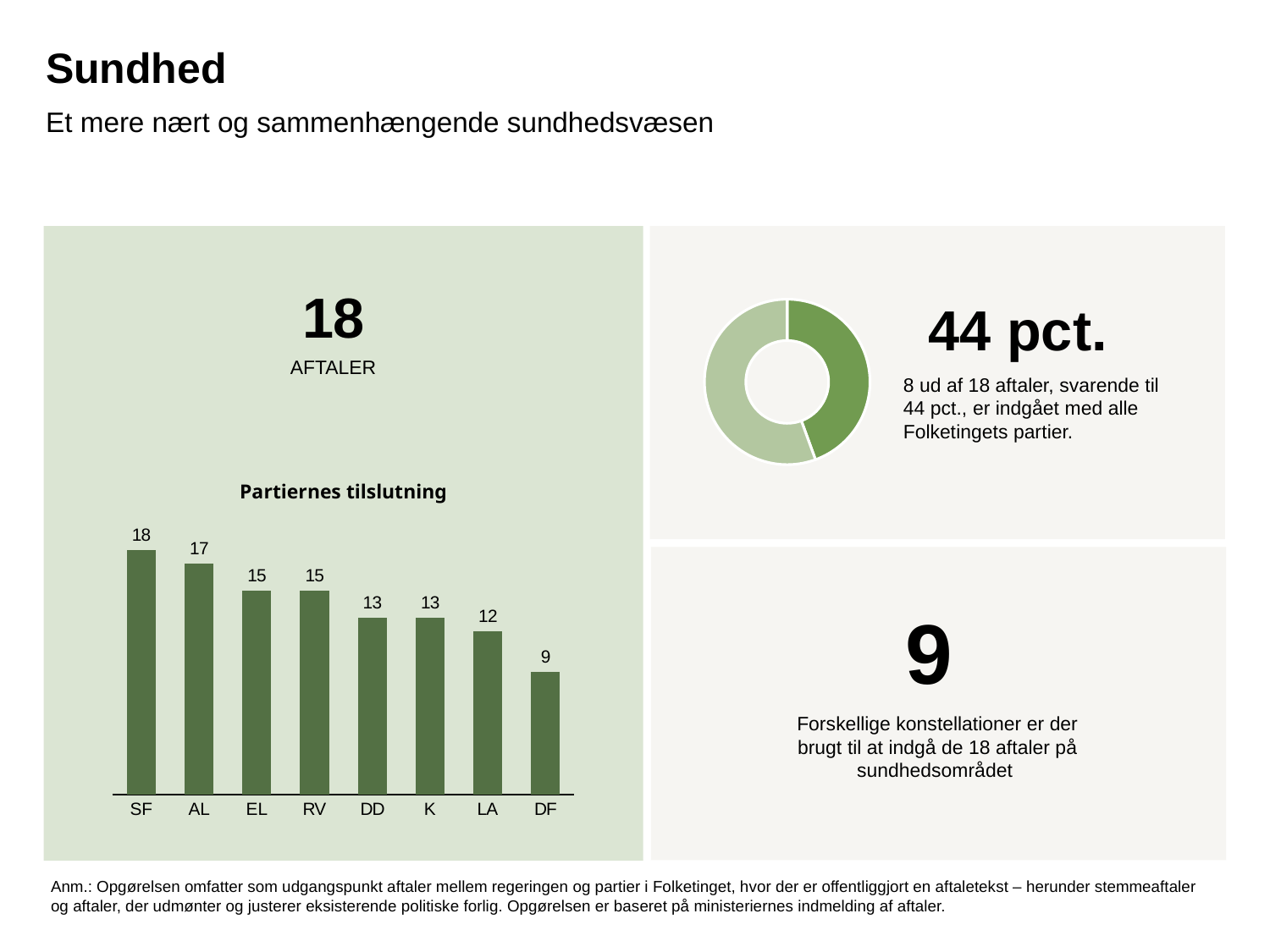
In the 'Partiernes tilslutning' chart, do the values rise or fall from left to right? fall In the 'Partiernes tilslutning' chart, which is larger, the value for EL or the value for LA? EL In the 'Partiernes tilslutning' chart, which party has the highest value? SF In the donut chart on the right, what share of the agreements does the darker green slice represent? 44 pct. In the 'Partiernes tilslutning' chart, what is the value for LA? 12 What kind of chart is 'Partiernes tilslutning'? bar chart How many parties are shown in the 'Partiernes tilslutning' chart? 8 In the 'Partiernes tilslutning' chart, which party has the lowest value? DF In the 'Partiernes tilslutning' chart, what is the difference between the values for SF and DF? 9 In the 'Partiernes tilslutning' chart, what is the difference between the values for AL and DD? 4 In the 'Partiernes tilslutning' chart, what is the value for DF? 9 In the 'Partiernes tilslutning' chart, what is the value for SF? 18